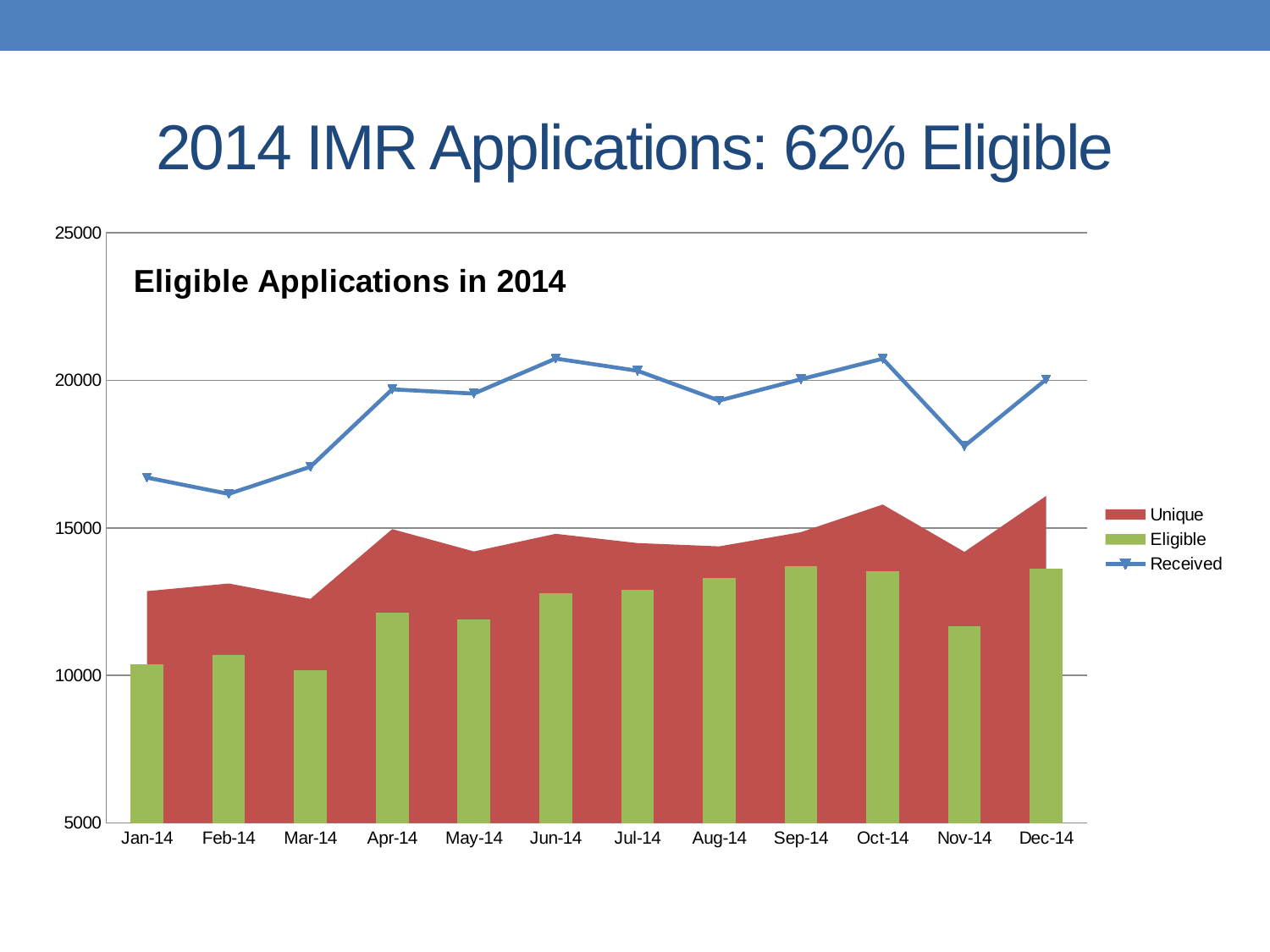
Which month has the lowest Received value? Feb-14 How many series does the chart legend list? 3 Which is larger, the Received value for Apr-14 or for Feb-14? Apr-14 What kind of chart is used to plot the Eligible series? Bar chart Is the Received value for Nov-14 greater or less than 20000? less How many months are shown on the x axis of the chart? 12 Which month has the lowest Eligible value? Mar-14 What is the title shown inside the chart area? Eligible Applications in 2014 What kind of chart is used to plot the Received series? Line chart Is the Unique value for Dec-14 greater or less than 15000? greater Is the Eligible value for Jan-14 greater or less than 10000? greater Which month has the highest Unique value? Dec-14